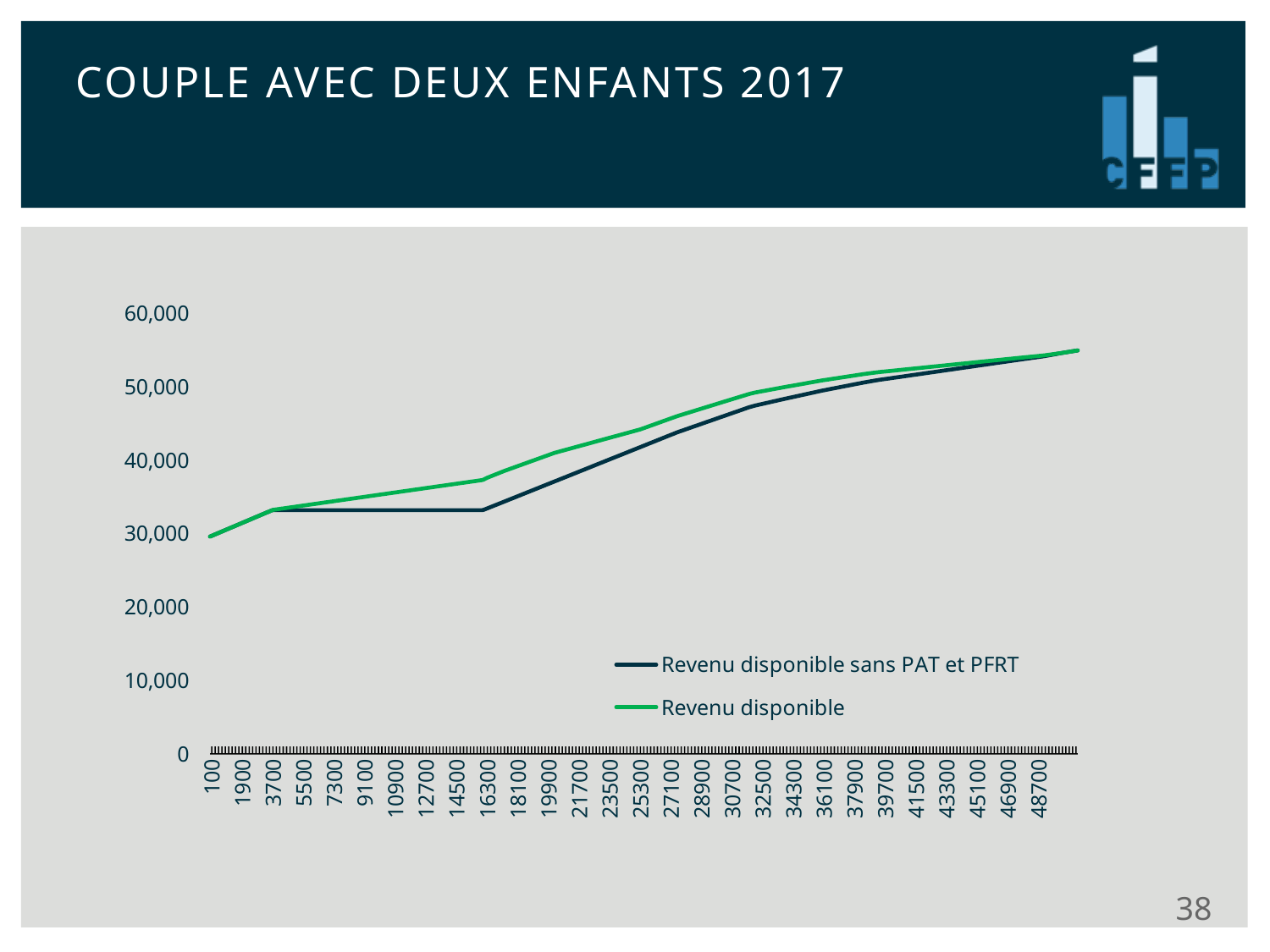
What are the two series named in the legend? Revenu disponible sans PAT et PFRT; Revenu disponible How many series does the legend list? 2 Do the values of the 'Revenu disponible' series rise or fall as you move along the x axis? rise What is the title of the slide containing the chart? COUPLE AVEC DEUX ENFANTS 2017 Is the value of 'Revenu disponible' at x = 16300 greater or less than 40,000? less Do the values of the 'Revenu disponible sans PAT et PFRT' series rise or fall overall along the x axis? rise Is the value of 'Revenu disponible sans PAT et PFRT' at x = 16300 greater or less than 30,000? greater What kind of chart is shown on the slide? line chart Is the value of 'Revenu disponible' at x = 48700 greater or less than 50,000? greater At x = 16300, which series has the larger value: 'Revenu disponible' or 'Revenu disponible sans PAT et PFRT'? Revenu disponible At x = 25300, which series has the larger value: 'Revenu disponible' or 'Revenu disponible sans PAT et PFRT'? Revenu disponible